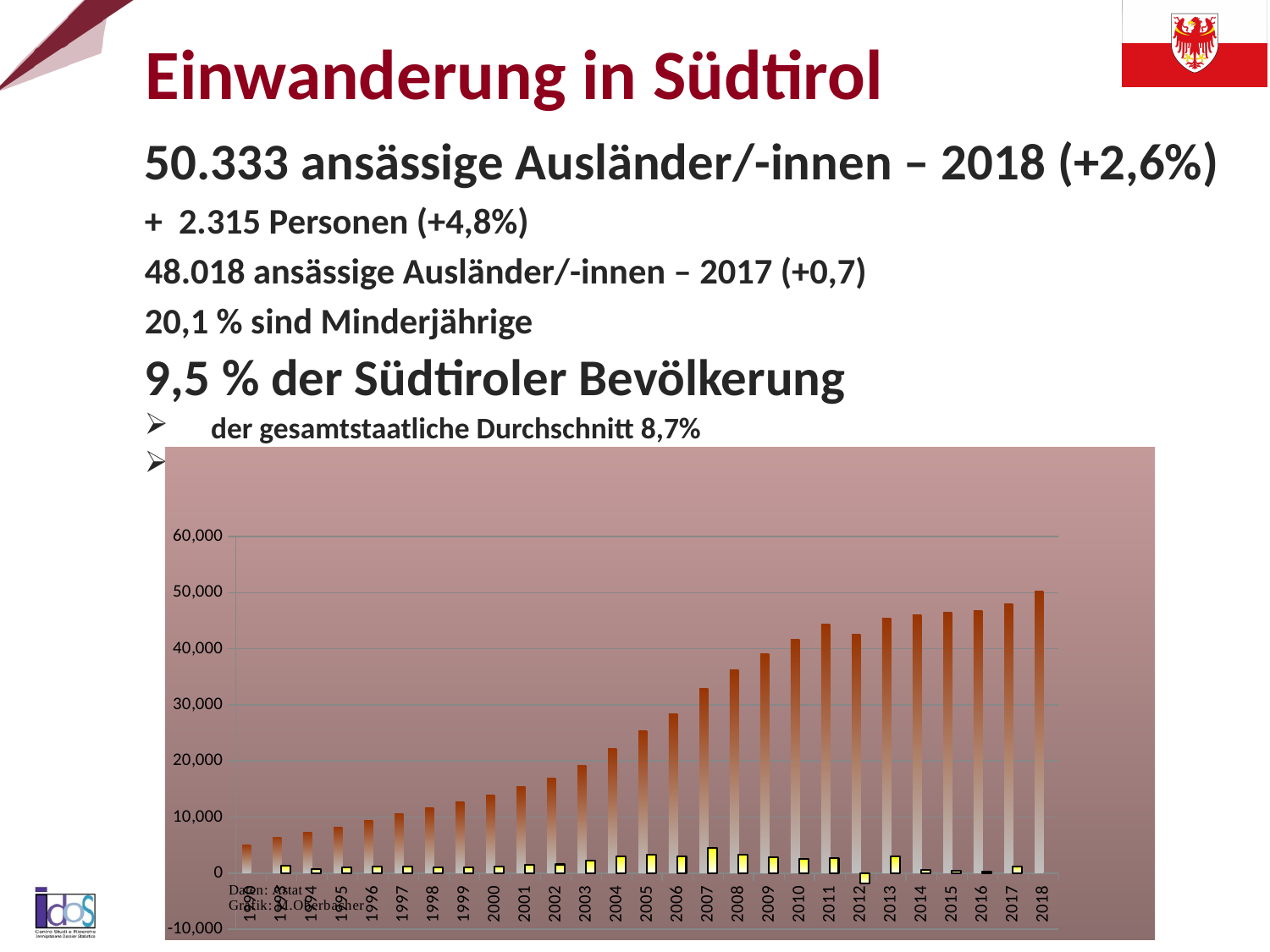
What kind of chart is shown on the slide? bar chart Which year has the larger brown bar, 2005 or 2010? 2010 Is the brown bar for 2010 greater or less than 40,000? greater Is the brown bar for 2000 greater or less than 10,000? greater Is the brown bar for 2007 greater or less than 30,000? greater Which year has the larger brown bar, 1998 or 2003? 2003 What is the highest value shown on the vertical axis of the chart? 60,000 Which year has the tallest brown bar in the chart? 2018 In which year does the small yellow bar fall below zero? 2012